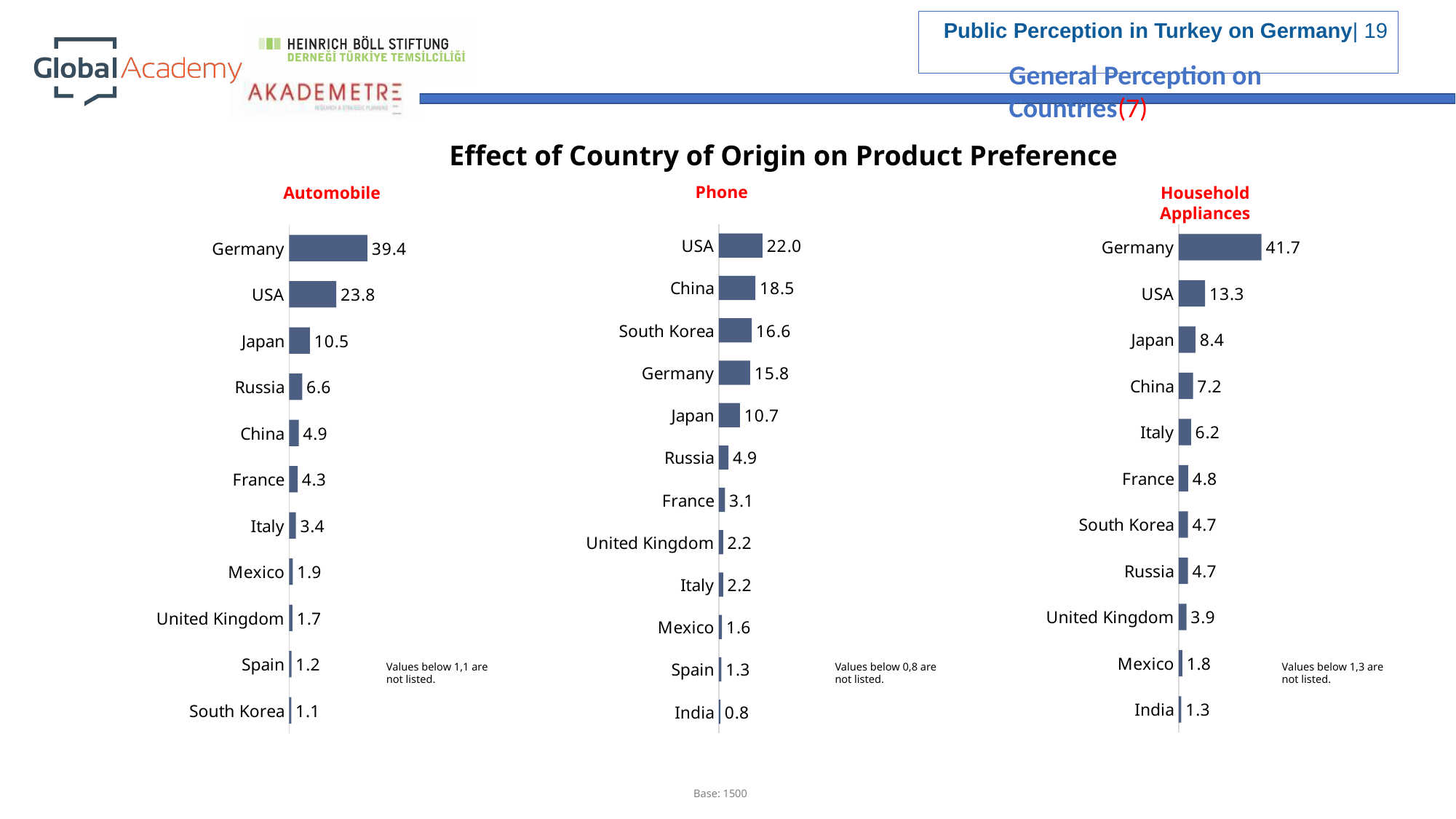
How many countries are listed in the Phone chart? 12 In the Automobile chart, which country has the lowest value? South Korea What type of chart is the Automobile chart? Bar chart In the Automobile chart, which is larger, the value for Japan or the value for Russia? Japan What is the overall title shown above the three charts? Effect of Country of Origin on Product Preference In the Household Appliances chart, what is the value for Japan? 8.4 In the Phone chart, what is the value for South Korea? 16.6 In the Phone chart, which country has the highest value? USA In the Household Appliances chart, what is the difference between the values for Germany and USA? 28.4 In the Phone chart, what is the difference between the values for USA and China? 3.5 How many countries are listed in the Household Appliances chart? 11 In the Automobile chart, what is the value for Germany? 39.4